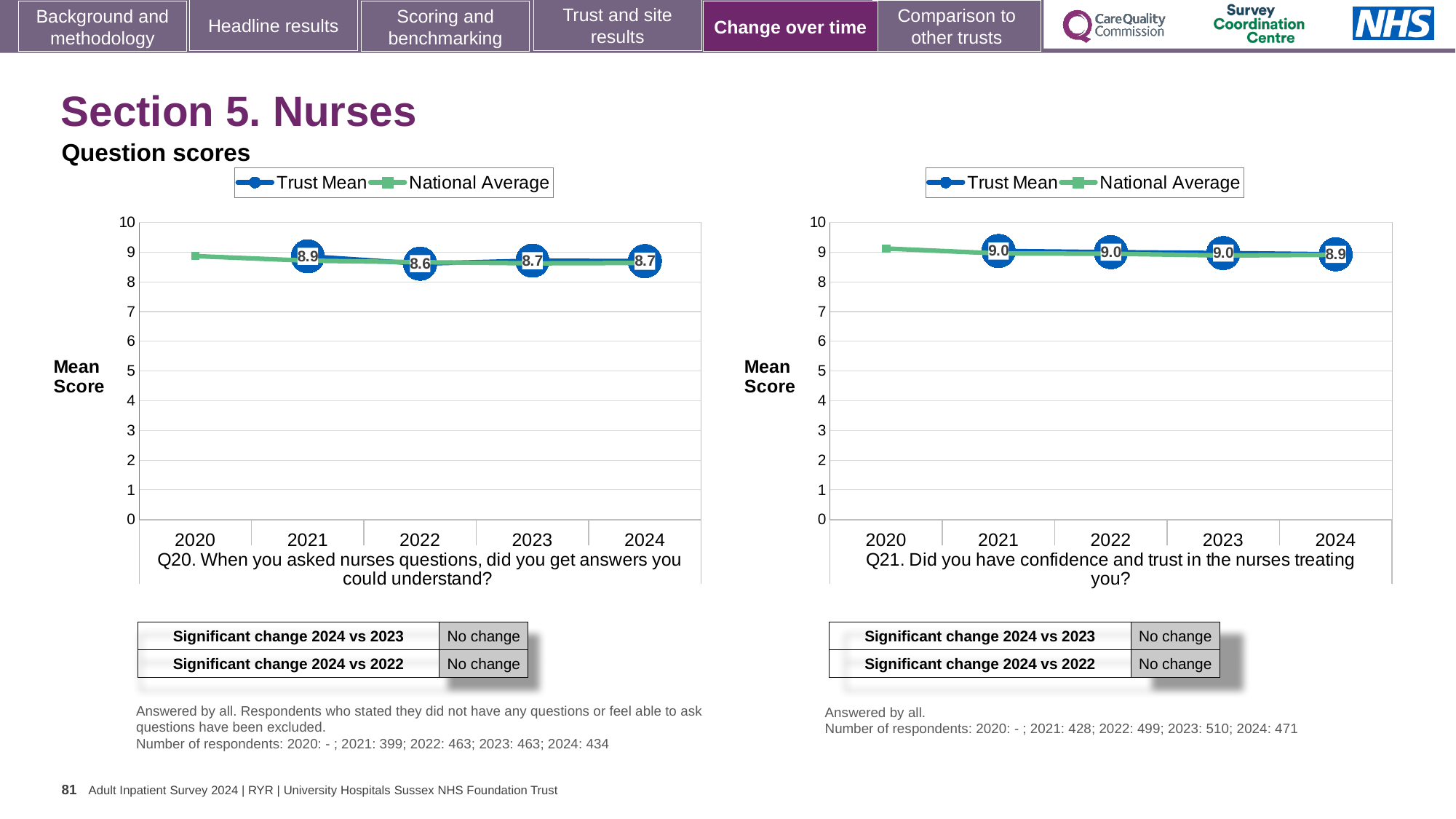
On the Q21 chart (right), in which year is the Trust Mean score lowest? 2024 On the Q21 chart (right), what is the Trust Mean score for 2023? 9.0 On the Q20 chart (left), in which year is the Trust Mean score lowest? 2022 How many years are shown on the x axis of the Q21 chart (right)? 5 On the Q20 chart (left), what is the Trust Mean score for 2021? 8.9 On the Q20 chart (left), in which year is the Trust Mean score highest? 2021 On the Q20 chart (left), is the National Average value for 2020 greater or less than 8? greater What type of chart is the Q21 chart (right)? Line chart How many series does the legend of the Q20 chart (left) list? 2 On the Q20 chart (left), what is the difference between the Trust Mean scores for 2021 and 2022? 0.3 On the Q20 chart (left), what is the Trust Mean score for 2022? 8.6 On the Q21 chart (right), what is the Trust Mean score for 2024? 8.9